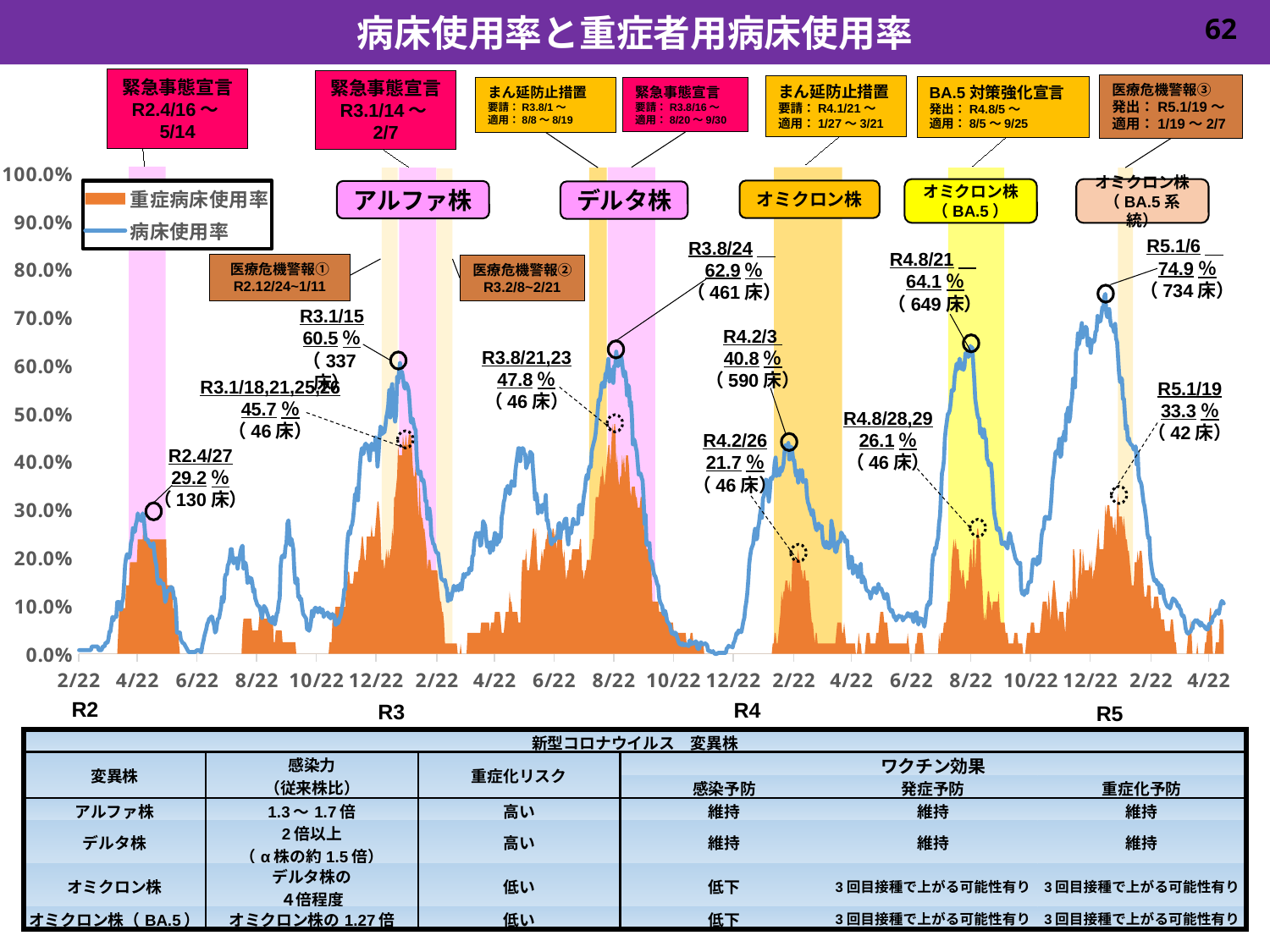
凡例にはいくつの系列が示されていますか？ 2 凡例で「重症病床使用率」は何色で示されていますか？ オレンジ R3.8/24 の病床使用率（62.9%）と R3.8/21,23 の重症病床使用率（47.8%）の差は何ポイントですか？ 15.1ポイント R4.2/3 の病床使用率に対応する病床数はいくつですか？ 590床 R3.8/21,23 の重症病床使用率は何%ですか？ 47.8% R3.8/24 の病床使用率は何%ですか？ 62.9% R5.1/6 の病床使用率（74.9%）と R4.8/21 の病床使用率（64.1%）の差は何ポイントですか？ 10.8ポイント R3.1/15 と R3.8/24 では、どちらの病床使用率が高いですか？ R3.8/24 ラベル付きの病床使用率のピークのうち、最も高いのはどの日付ですか？ R5.1/6（74.9%） R5.1/6 の病床使用率は何%ですか？ 74.9% R4.8/28,29 の重症病床使用率は何%ですか？ 26.1% ラベル付きの重症病床使用率のピークのうち、最も低いのはどの日付ですか？ R4.2/26（21.7%）